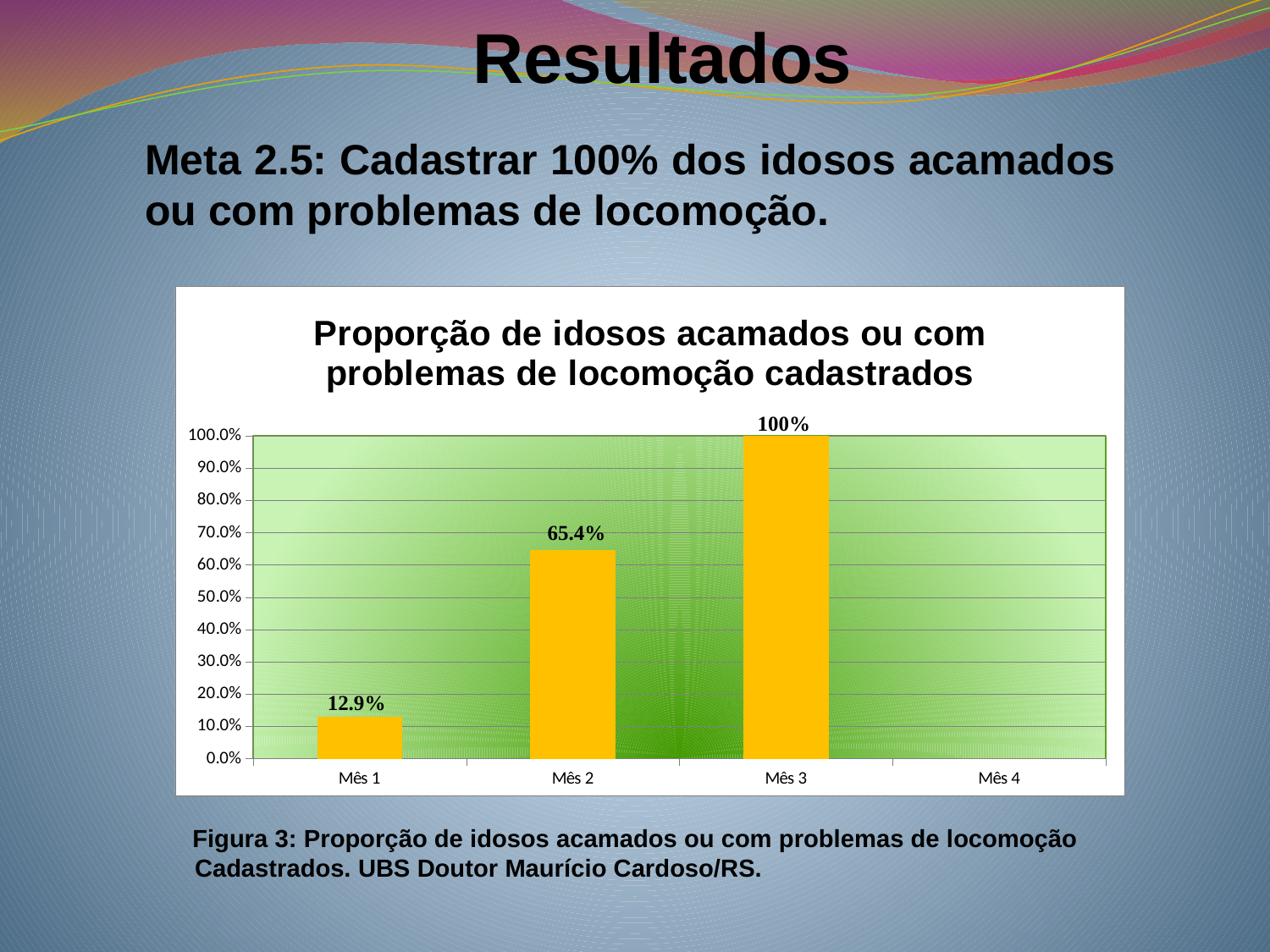
What is the difference between the values for Mês 3 and Mês 2? 34.6% Do the values rise or fall from Mês 1 to Mês 3? Rise Is the value for Mês 2 greater or less than 60.0%? greater What is the value for Mês 1? 12.9% What is the value for Mês 2? 65.4% How many month categories are labeled on the x axis? 4 What kind of chart is shown? Bar chart What is the difference between the values for Mês 2 and Mês 1? 52.5% Which month with a plotted bar has the lowest value? Mês 1 Which month has the highest value? Mês 3 Which is larger, the value for Mês 1 or the value for Mês 2? Mês 2 What is the value for Mês 3? 100%